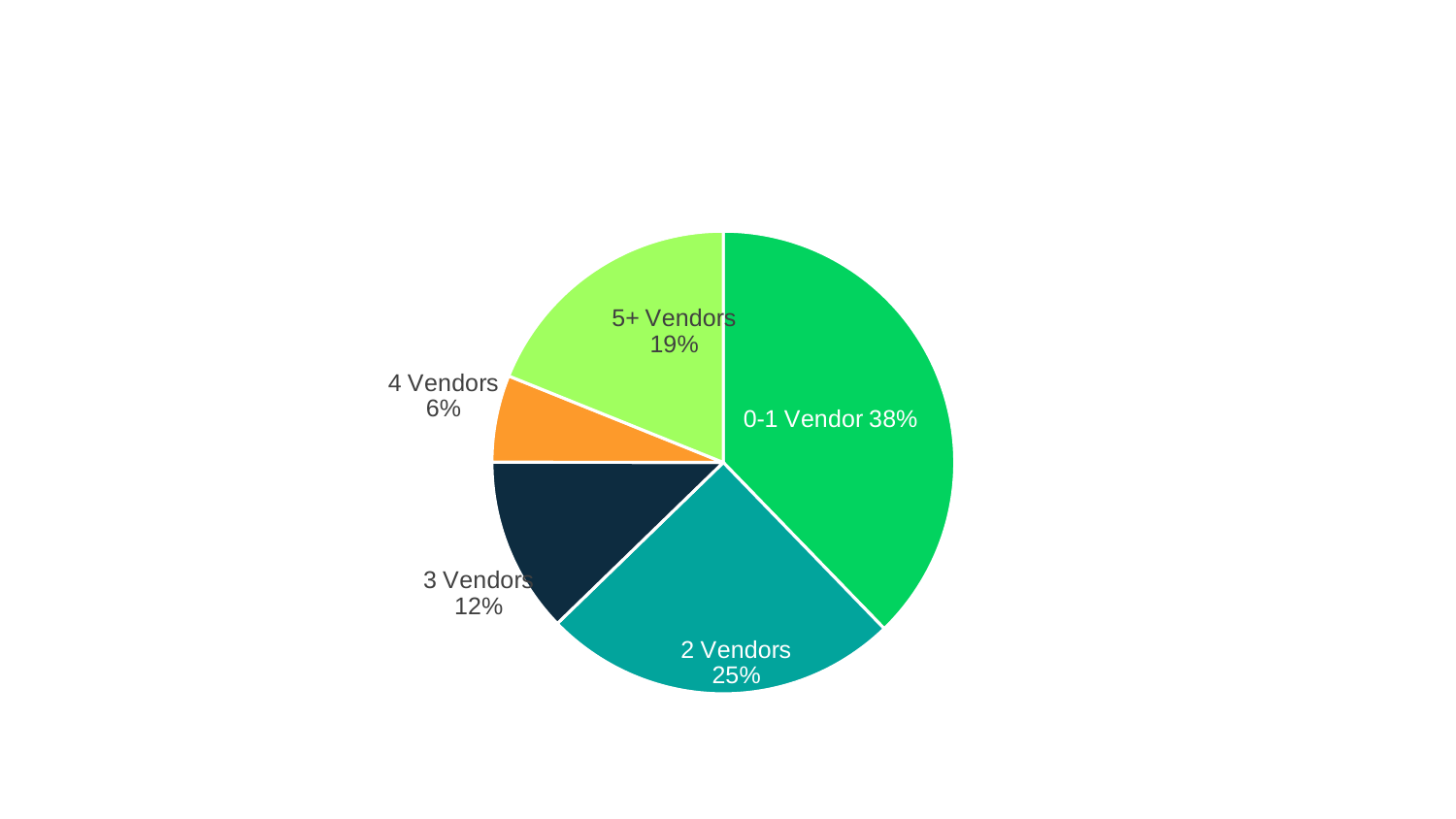
What kind of chart is shown on the slide? pie chart Which is larger, the share for 5+ Vendors or the share for 3 Vendors? 5+ Vendors What is the value shown for 5+ Vendors? 19% What is the value shown for 3 Vendors? 12% What is the value shown for 2 Vendors? 25% Which category has the largest slice of the pie? 0-1 Vendor Which category has the smallest slice of the pie? 4 Vendors What colour is the 4 Vendors slice? orange What is the value shown for 4 Vendors? 6% How many slices does the pie chart have? 5 What is the difference between the 0-1 Vendor share and the 2 Vendors share? 13% What share of the pie does the 0-1 Vendor slice represent? 38%